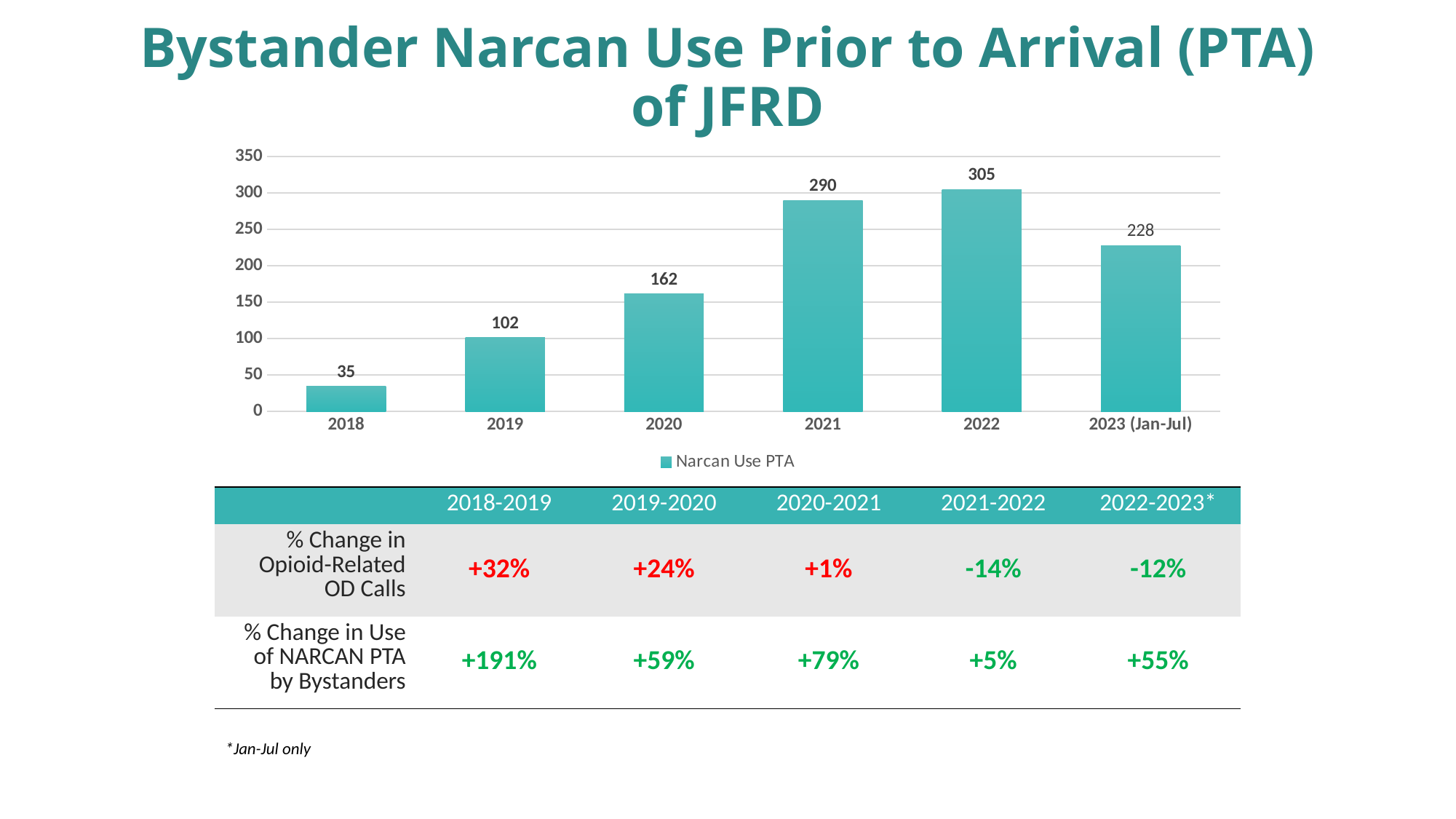
How many years (categories) are shown on the x axis of the chart? 6 Is the Narcan Use PTA value for 2020 greater or less than 150? greater Which year has the lowest Narcan Use PTA value? 2018 What is the difference between the Narcan Use PTA values for 2022 and 2021? 15 How many series does the chart legend list? 1 Which is larger, the Narcan Use PTA value for 2021 or for 2023 (Jan-Jul)? 2021 What kind of chart is shown on the slide? Bar chart What is the name of the series shown in the chart legend? Narcan Use PTA What is the Narcan Use PTA value for 2020? 162 What is the difference between the Narcan Use PTA values for 2019 and 2018? 67 What is the Narcan Use PTA value for 2023 (Jan-Jul)? 228 Which year has the highest Narcan Use PTA value? 2022